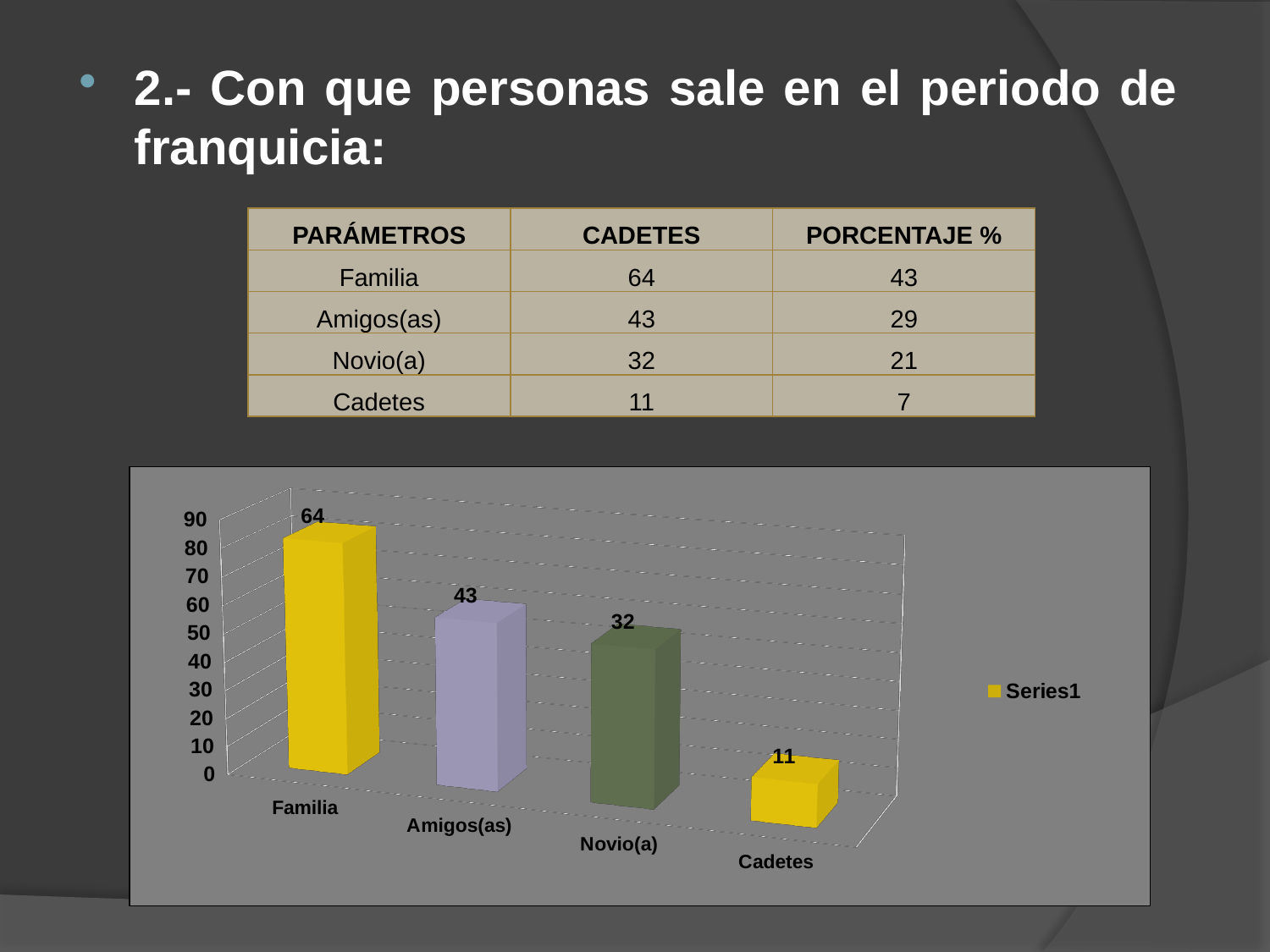
Which category has the lowest value in the chart? Cadetes What is the value for Cadetes in the chart? 11 How many series does the chart legend list? 1 How many categories are shown in the chart? 4 What is the name of the series shown in the chart legend? Series1 Which category has the highest value in the chart? Familia What kind of chart is shown on the slide? Bar chart What is the value for Amigos(as) in the chart? 43 What is the value for Familia in the chart? 64 What is the difference between the values for Familia and Amigos(as)? 21 Which is larger, the value for Novio(a) or the value for Cadetes? Novio(a) What is the value for Novio(a) in the chart? 32